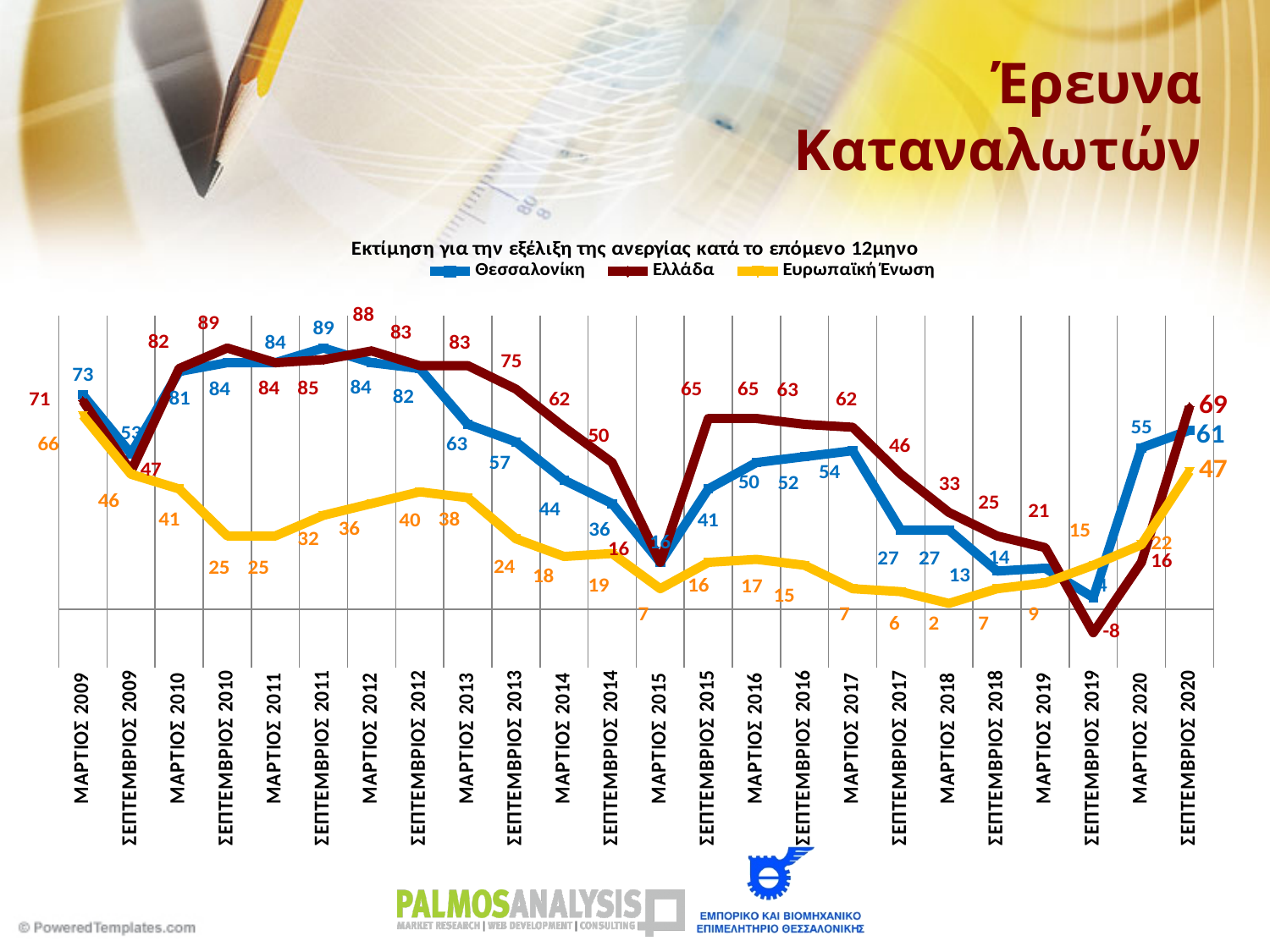
In ΣΕΠΤΕΜΒΡΙΟΣ 2009, which is larger: the value for Θεσσαλονίκη or for Ελλάδα? Θεσσαλονίκη What is the value for Ευρωπαϊκή Ένωση in ΣΕΠΤΕΜΒΡΙΟΣ 2019? 15 How many time points are plotted along the x axis? 24 What is the value for Θεσσαλονίκη in ΣΕΠΤΕΜΒΡΙΟΣ 2020? 61 What kind of chart is shown on the slide? Line chart In which period does the Ευρωπαϊκή Ένωση series reach its lowest value? ΜΑΡΤΙΟΣ 2018 What is the value for Ελλάδα in ΣΕΠΤΕΜΒΡΙΟΣ 2019? -8 What is the difference between the Ελλάδα and Θεσσαλονίκη values in ΣΕΠΤΕΜΒΡΙΟΣ 2020? 8 What is the value for Ελλάδα in ΣΕΠΤΕΜΒΡΙΟΣ 2020? 69 What is the title of the chart? Εκτίμηση για την εξέλιξη της ανεργίας κατά το επόμενο 12μηνο How many series does the legend list? 3 In which period does the Ελλάδα series reach its highest value? ΣΕΠΤΕΜΒΡΙΟΣ 2010